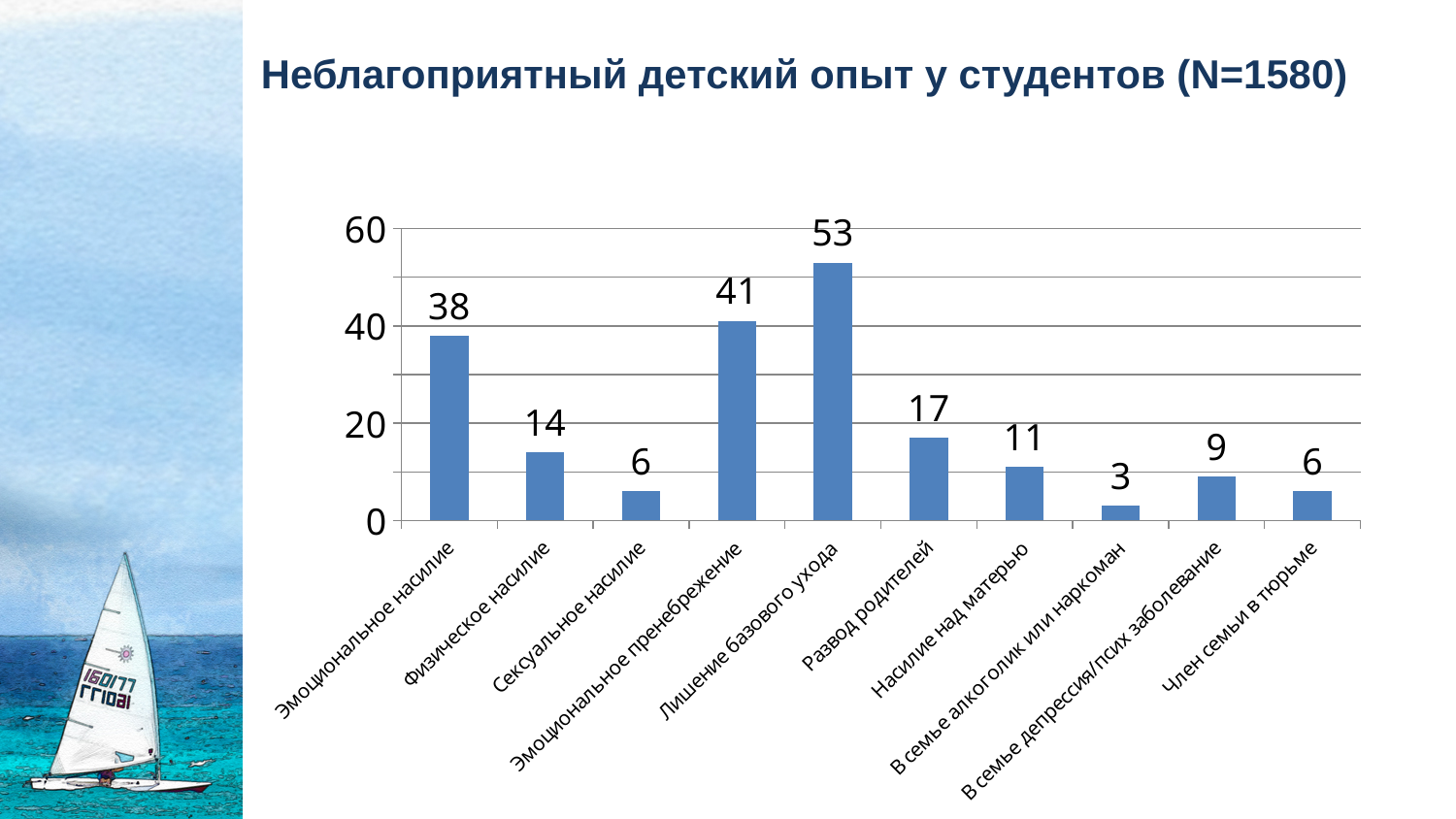
How many categories are shown in the chart? 10 Is the value for Эмоциональное насилие greater or less than 20? greater What kind of chart is shown on the slide? bar chart Which is larger, the value for Физическое насилие or the value for Развод родителей? Развод родителей What is the value for Эмоциональное пренебрежение? 41 What is the difference between the values for Сексуальное насилие and Член семьи в тюрьме? 0 What is the difference between the values for Лишение базового ухода and Эмоциональное насилие? 15 What is the value for Насилие над матерью? 11 What is the value for Лишение базового ухода? 53 Which category has the lowest value? В семье алкоголик или наркоман What is the title of the chart? Неблагоприятный детский опыт у студентов (N=1580) Which category has the highest value? Лишение базового ухода